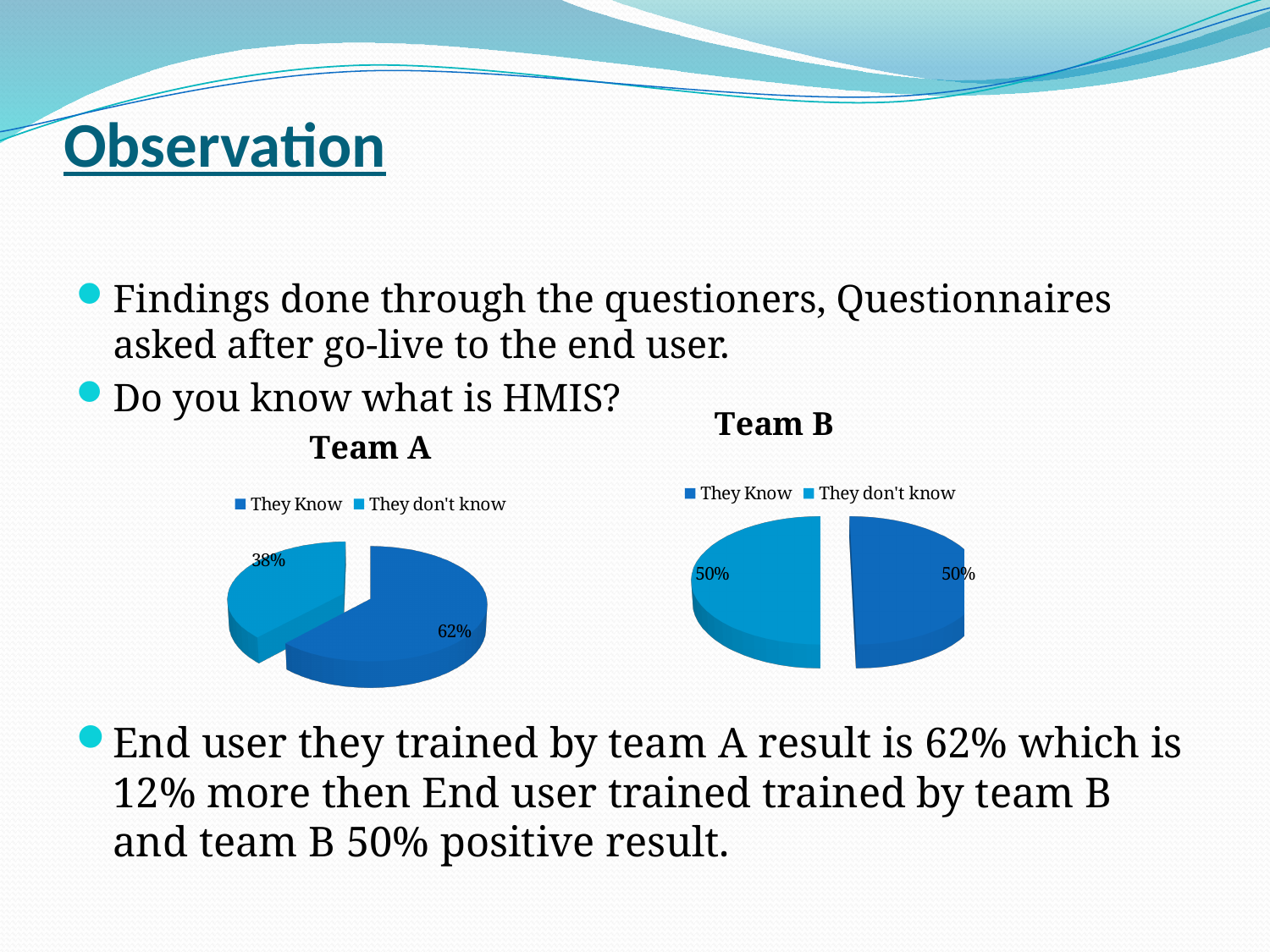
In the Team A chart, which slice is the smallest? They don't know In the Team A chart, what is the difference between the "They Know" and "They don't know" slices? 24% In the Team A chart, which slice is the largest? They Know What kind of chart is the Team B chart? Pie chart In the Team B chart, what percentage is shown for "They Know"? 50% In the Team A chart, what percentage is shown for "They don't know"? 38% What are the two legend entries in the Team A chart? They Know, They don't know In the Team A chart, which is larger: "They Know" or "They don't know"? They Know What is the title of the chart on the left? Team A How many entries does the legend of the Team B chart list? 2 In the Team A chart, what percentage is shown for "They Know"? 62% How many slices does the Team A chart have? 2